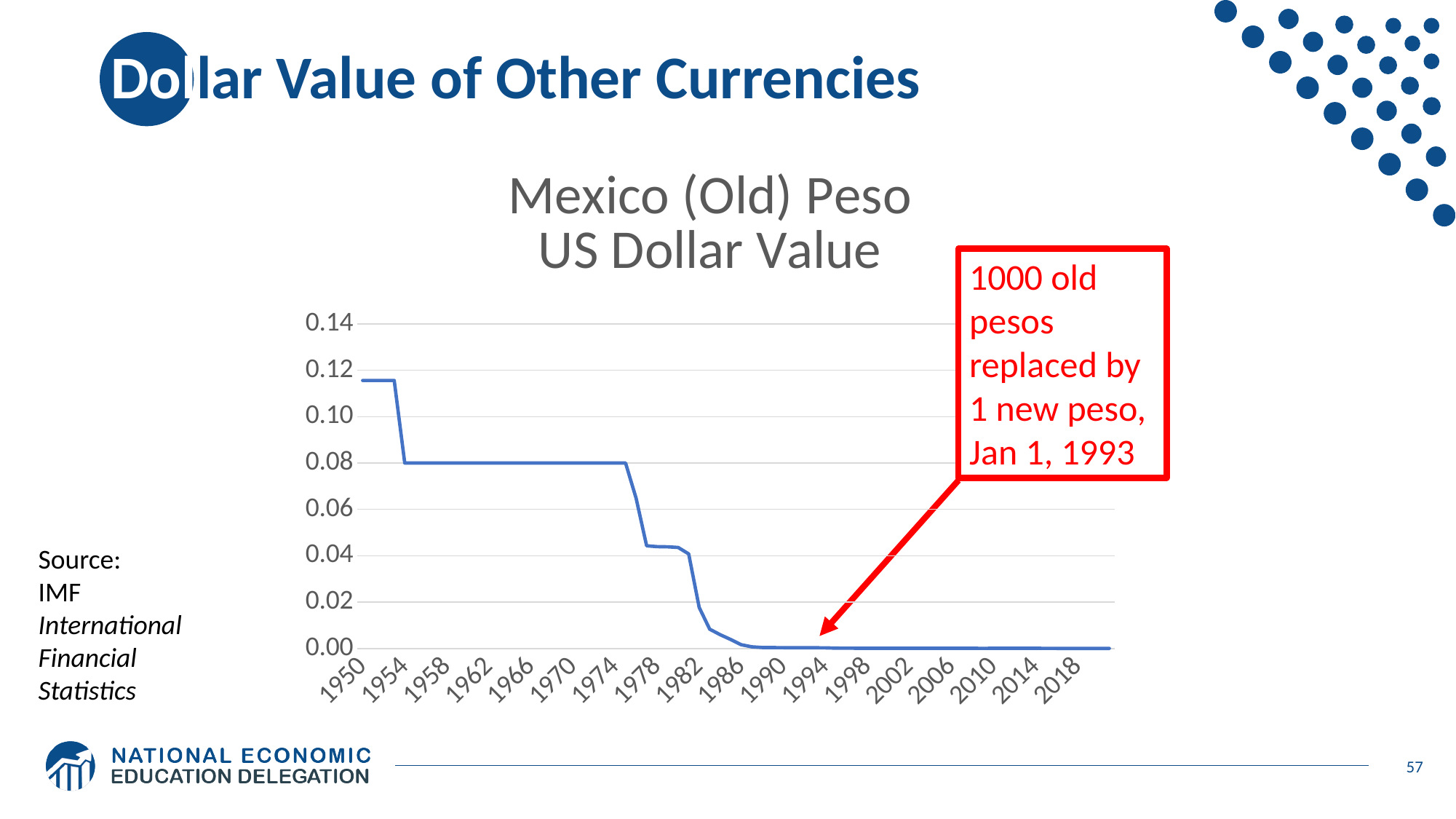
What kind of chart is shown on the slide? line chart Is the value for 1966 greater or less than 0.10? less Which year shown on the x axis has the highest US dollar value of the old peso? 1950 What is the title of the chart? Mexico (Old) Peso US Dollar Value Is the value in 1970 larger or smaller than the value in 1986? larger Is the value for 1978 greater or less than 0.04? greater Do the values rise or fall from 1950 to 2018? fall Is the value for 2010 greater or less than 0.02? less How many year labels are shown on the x axis? 18 What is the US dollar value of the old peso in 1966? 0.08